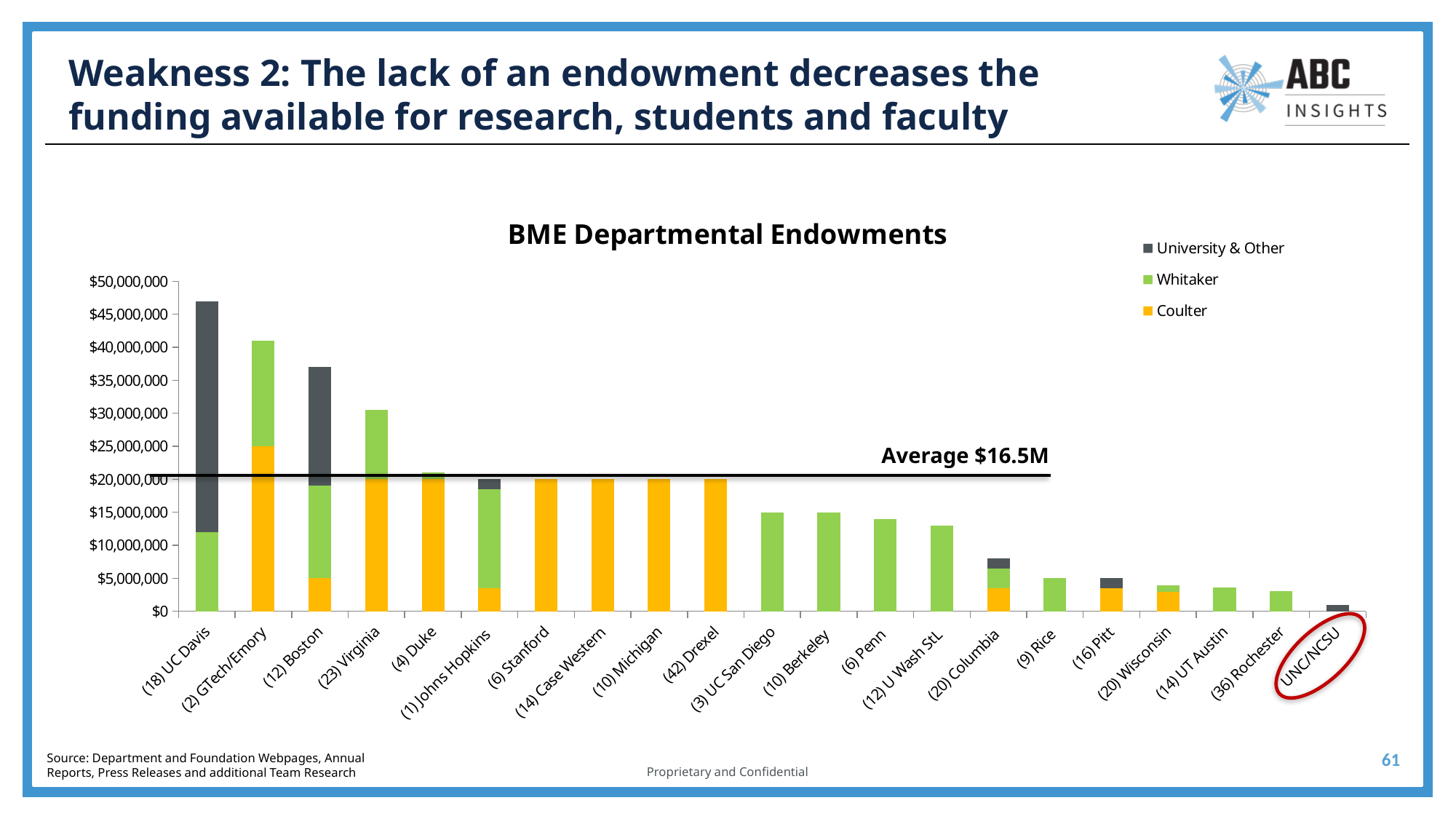
Which institution has the highest total endowment in the chart? (18) UC Davis Is the total endowment for (18) UC Davis greater or less than $45,000,000? greater How many series does the legend of the BME Departmental Endowments chart list? 3 Do the total endowments generally rise or fall moving from left to right along the x axis? fall Which has the larger total endowment, (18) UC Davis or (2) GTech/Emory? (18) UC Davis Is the total endowment for (20) Columbia greater or less than $5,000,000? greater What type of chart is shown on the slide? Stacked bar chart How many institutions are shown on the x axis of the BME Departmental Endowments chart? 21 Which institution has the lowest total endowment in the chart? UNC/NCSU What average value is labeled on the horizontal line in the chart? Average $16.5M Is the total endowment for (36) Rochester greater or less than $5,000,000? less